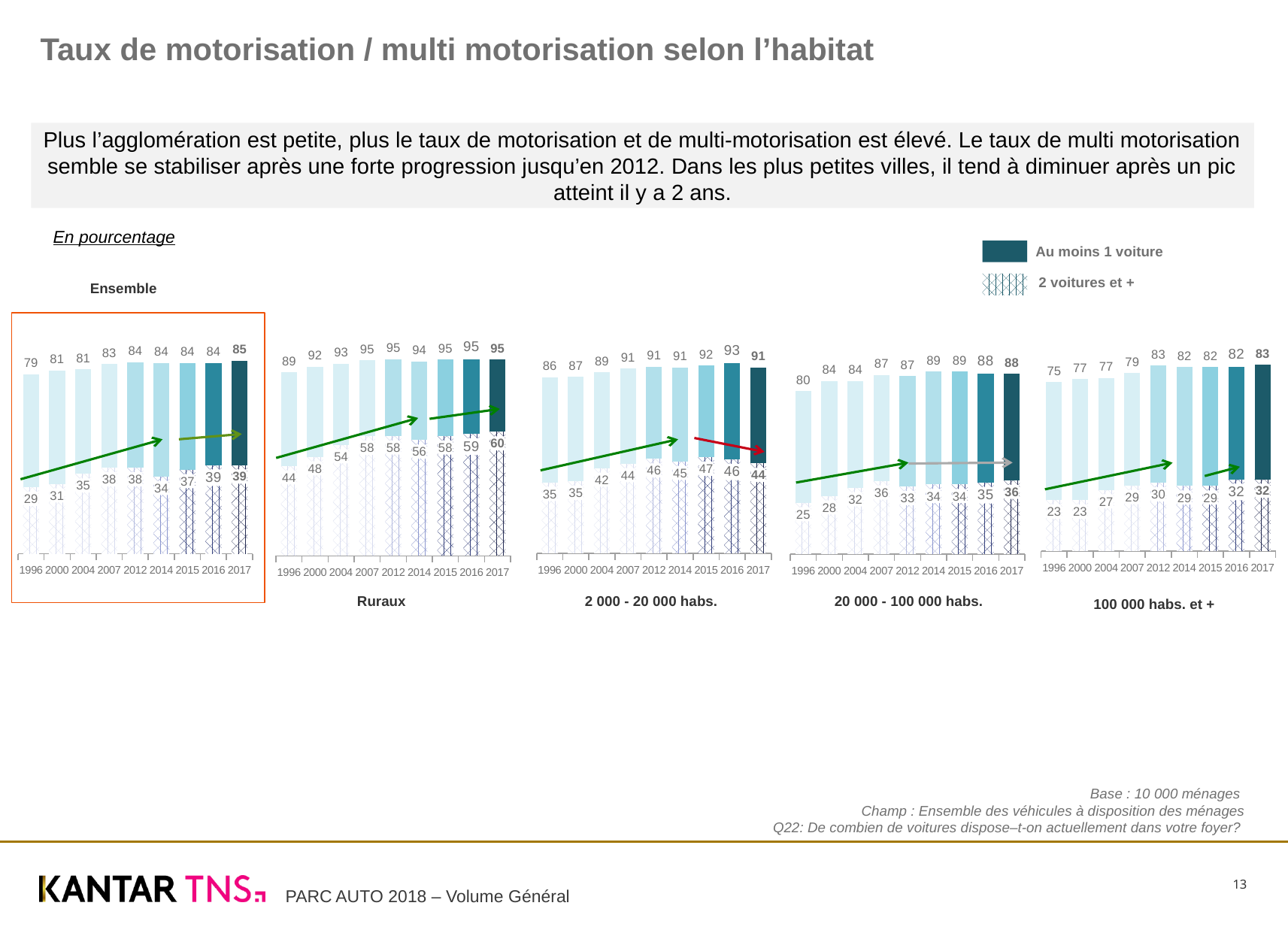
In the '100 000 habs. et +' chart, which year has the lowest value for 'Au moins 1 voiture'? 1996 In the '2 000 - 20 000 habs.' chart, what is the value for 'Au moins 1 voiture' in 2016? 93 How many series does the legend list? 2 How many years are shown on the x axis of the 'Ensemble' chart? 9 In the '20 000 - 100 000 habs.' chart, which year has the highest value for '2 voitures et +'? 2007 and 2017 (both 36) In the 'Ruraux' chart, what is the value for '2 voitures et +' in 2017? 60 In the '100 000 habs. et +' chart, does the 'Au moins 1 voiture' value rise or fall from 1996 to 2017? rise In the 'Ensemble' chart, what is the value for 'Au moins 1 voiture' in 2017? 85 In the 'Ensemble' chart, what is the difference between the 'Au moins 1 voiture' value in 2017 and in 1996? 6 In the '2 000 - 20 000 habs.' chart, is the '2 voitures et +' value in 2015 larger or smaller than in 2017? larger What kind of chart is the 'Ruraux' chart? bar chart In the 'Ruraux' chart, what is the difference between the '2 voitures et +' value in 2017 and in 1996? 16